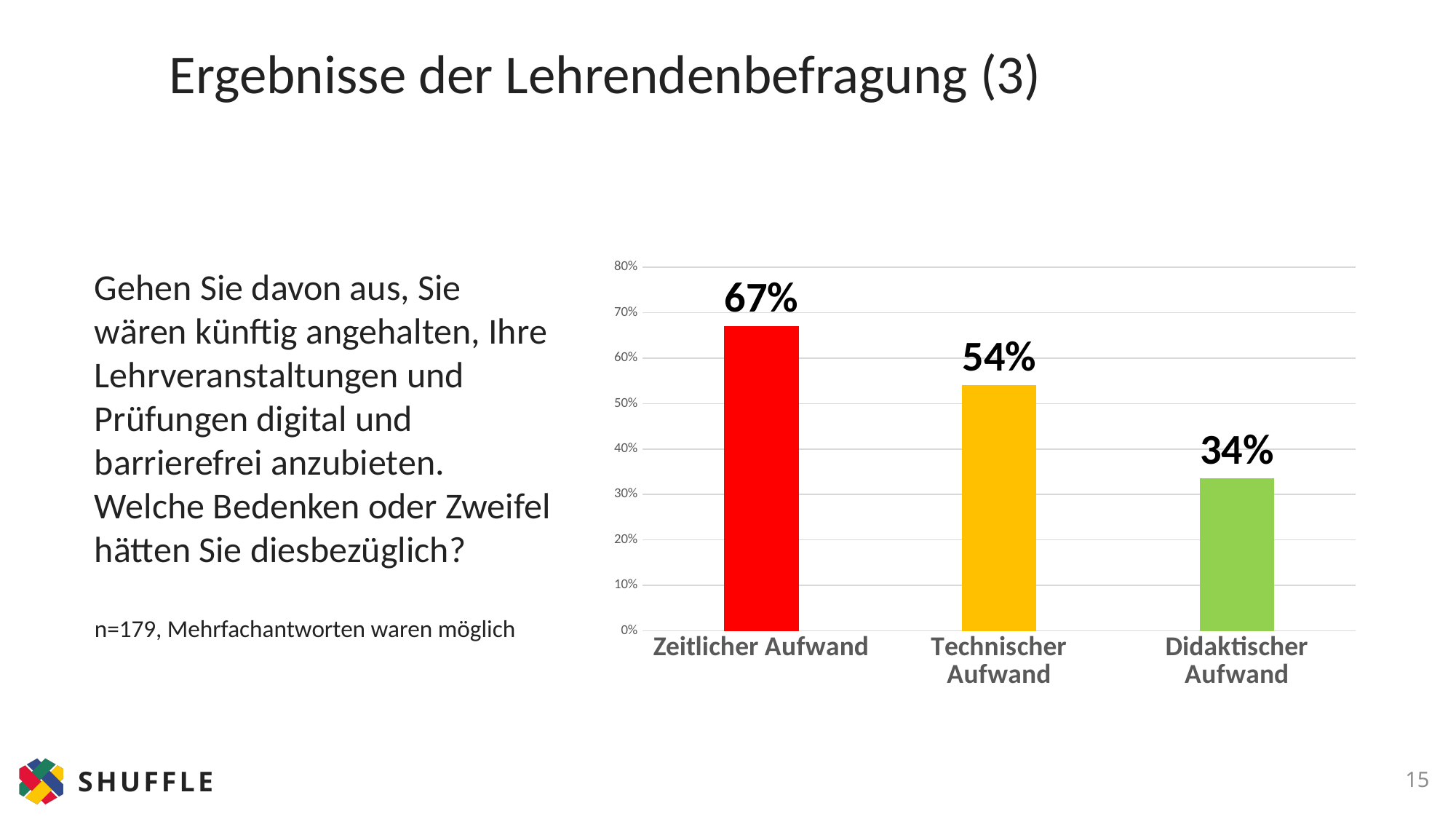
What is the value for Technischer Aufwand? 54% Which is larger, the value for Technischer Aufwand or the value for Didaktischer Aufwand? Technischer Aufwand What is the difference between the values for Zeitlicher Aufwand and Technischer Aufwand? 13% Which category has the lowest value? Didaktischer Aufwand What is the difference between the values for Technischer Aufwand and Didaktischer Aufwand? 20% How many categories are shown in the chart? 3 What kind of chart is shown on the slide? bar chart What is the value for Zeitlicher Aufwand? 67% What is the value for Didaktischer Aufwand? 34% What colour is the bar for Technischer Aufwand? yellow Is the value for Zeitlicher Aufwand greater or less than 60%? greater Which category has the highest value? Zeitlicher Aufwand